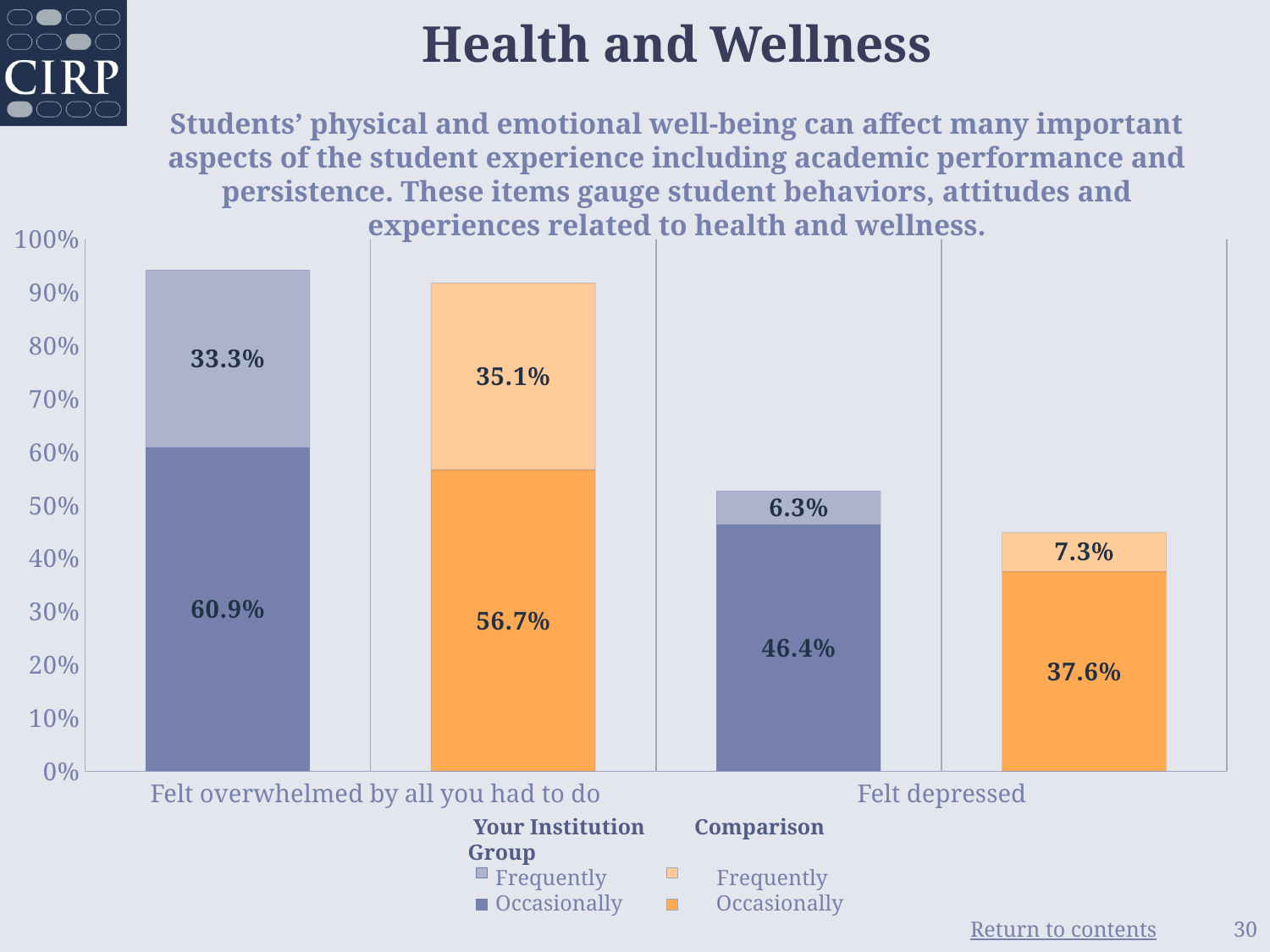
Which category has the lowest 'Frequently' value for Your Institution Group? Felt depressed Which is larger for frequently feeling overwhelmed: Your Institution Group or the Comparison Group? Comparison Group What is the difference between Your Institution Group and the Comparison Group for occasionally feeling depressed? 8.8% What is the total percentage of the Comparison Group who felt depressed (frequently plus occasionally)? 44.9% What percentage of Your Institution Group students occasionally felt depressed? 46.4% How many series does the legend list? 4 What kind of chart is shown on the slide? Stacked bar chart What is the total percentage of Your Institution Group students who felt overwhelmed by all they had to do (frequently plus occasionally)? 94.2% What percentage of Your Institution Group students occasionally felt overwhelmed by all they had to do? 60.9% What percentage of the Comparison Group frequently felt depressed? 7.3% How many categories are shown on the x axis? 2 What percentage of the Comparison Group frequently felt overwhelmed by all they had to do? 35.1%